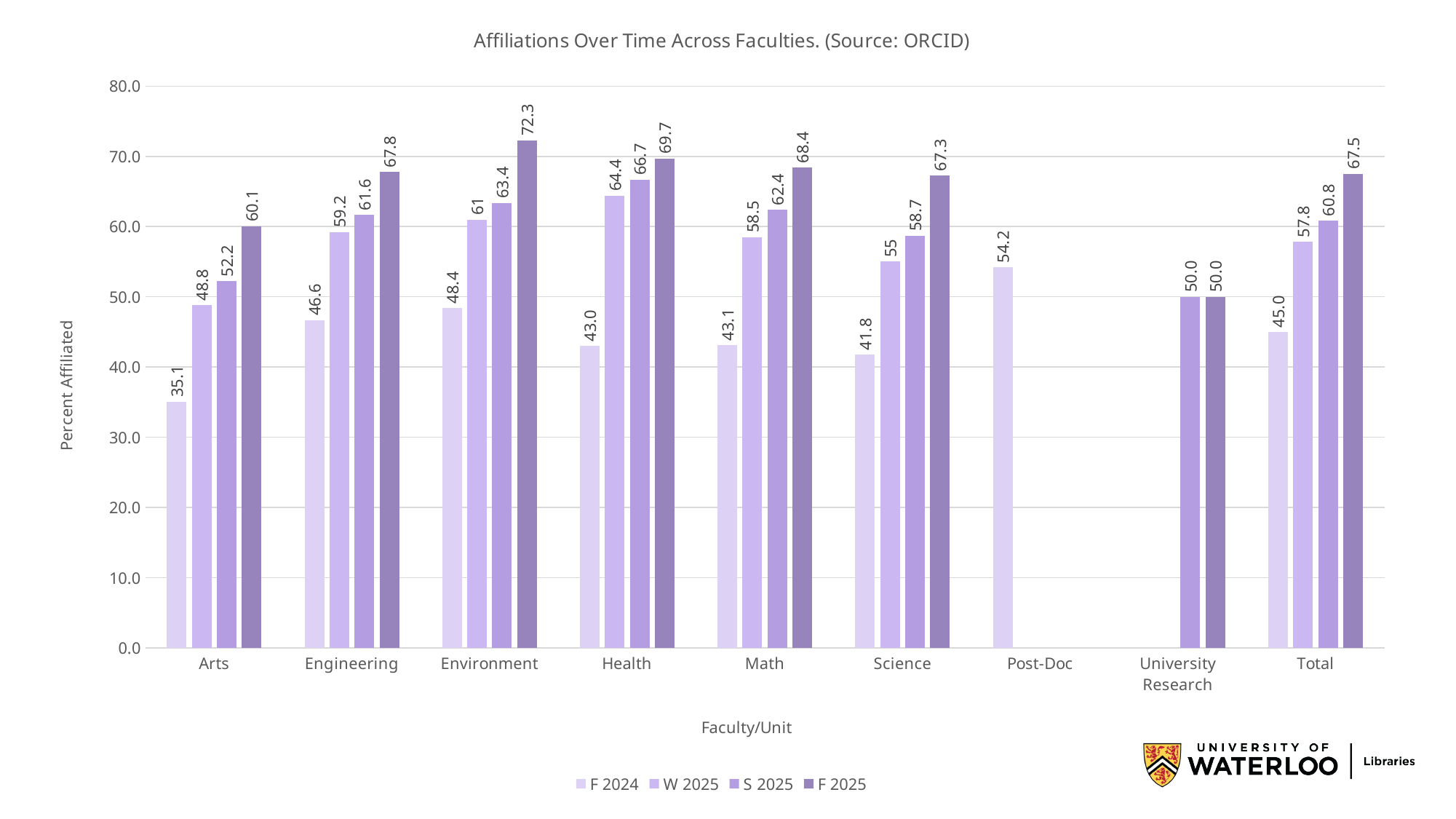
Do the values for Arts rise or fall from F 2024 to F 2025? rise Which faculty/unit has the lowest F 2024 value? Arts What is the F 2024 value for Arts? 35.1 Which faculty/unit has the highest F 2025 value? Environment Is the S 2025 value for Science greater or less than 60.0? less What is the difference between the F 2025 and F 2024 values for Total? 22.5 What kind of chart is shown on the slide? bar chart How many faculty/unit categories are shown on the x axis? 9 How many series does the legend list? 4 What is the F 2025 value for Environment? 72.3 Which is larger, the W 2025 value for Health or the W 2025 value for Engineering? Health What is the F 2024 value for Post-Doc? 54.2